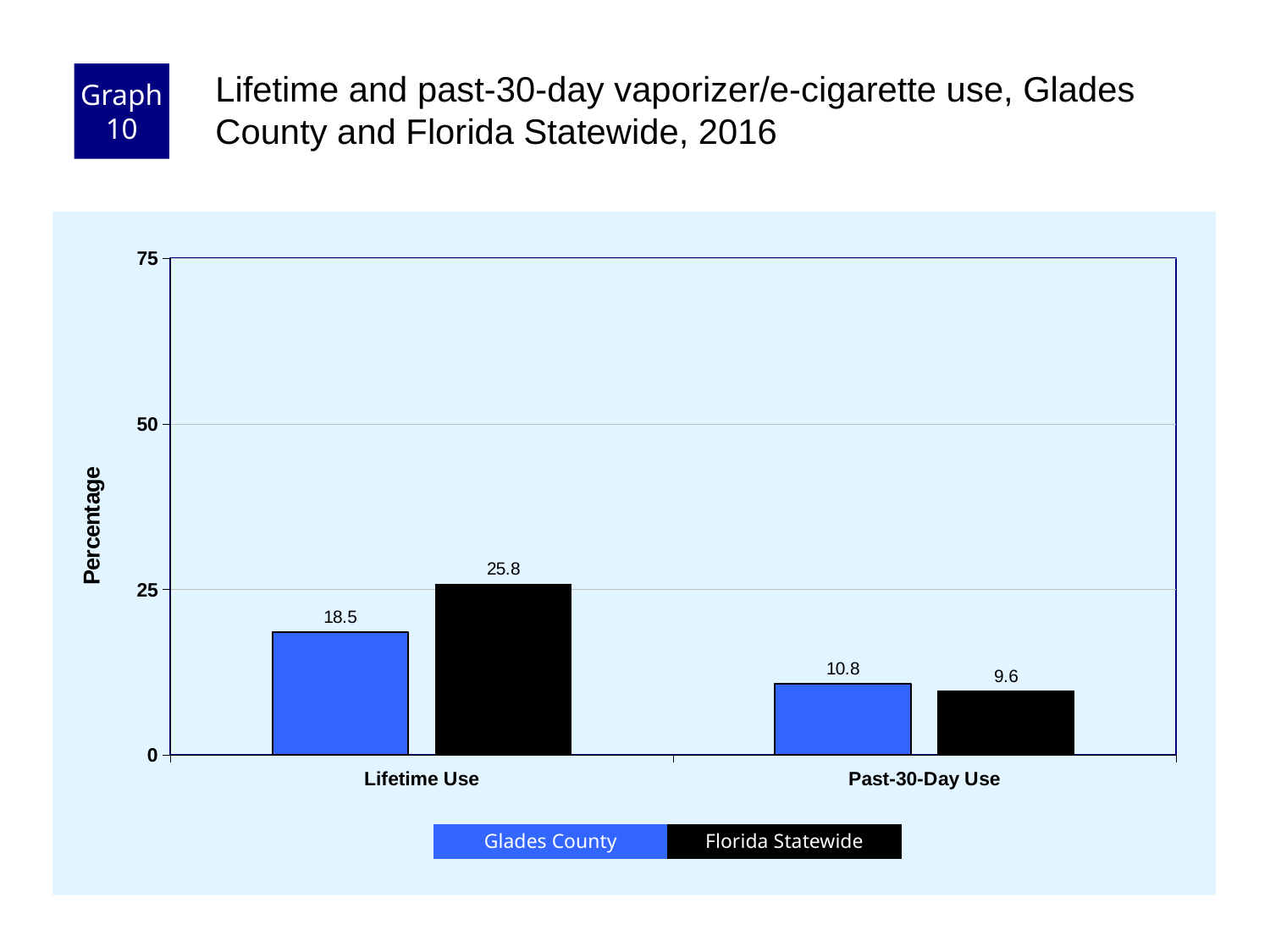
What is the Past-30-Day Use value for Florida Statewide? 9.6 For Past-30-Day Use, which is larger: Glades County or Florida Statewide? Glades County What is the Past-30-Day Use value for Glades County? 10.8 Which bar has the highest value on the chart? Florida Statewide, Lifetime Use What kind of chart is shown on the slide? Bar chart What is the Lifetime Use value for Glades County? 18.5 How many series does the legend list? 2 Is the Lifetime Use value for Florida Statewide greater or less than 25? greater How many categories are shown on the x axis? 2 Which bar has the lowest value on the chart? Florida Statewide, Past-30-Day Use What is the difference between the Florida Statewide and Glades County values for Lifetime Use? 7.3 What is the Lifetime Use value for Florida Statewide? 25.8